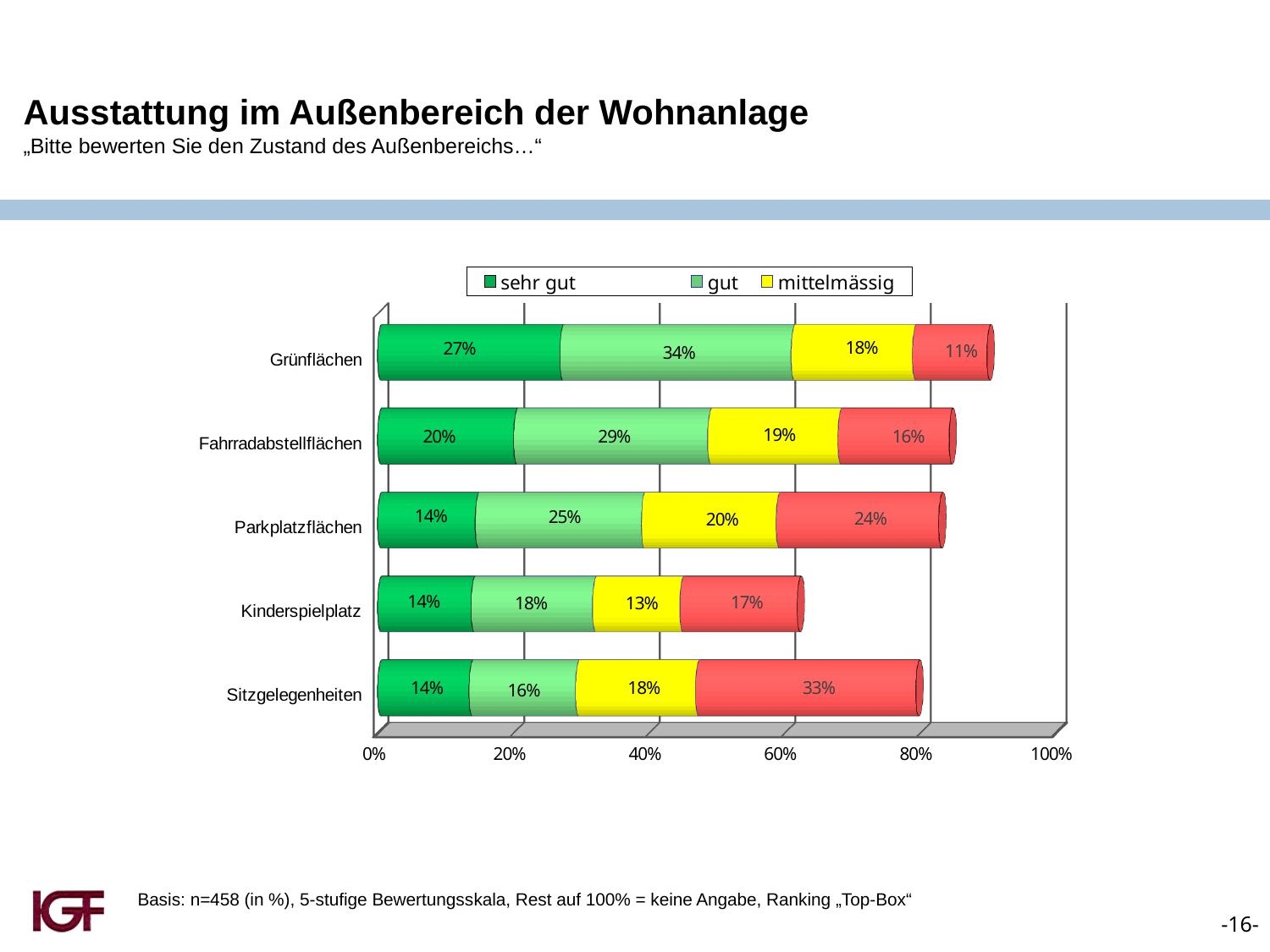
What is the "gut" value for Fahrradabstellflächen? 29% Which category has the lowest "gut" value? Sitzgelegenheiten Which category has the highest "sehr gut" value? Grünflächen What is the title of the slide containing the chart? Ausstattung im Außenbereich der Wohnanlage What is the "mittelmässig" value for Parkplatzflächen? 20% What kind of chart is shown on the slide? Stacked bar chart What is the "sehr gut" value for Grünflächen? 27% What is the difference between the "gut" values for Grünflächen and Kinderspielplatz? 16% How many categories are shown on the chart? 5 Which is larger: the "mittelmässig" value for Fahrradabstellflächen or for Kinderspielplatz? Fahrradabstellflächen What is the total of the stacked bar for Kinderspielplatz? 62% How many series does the legend list? 3